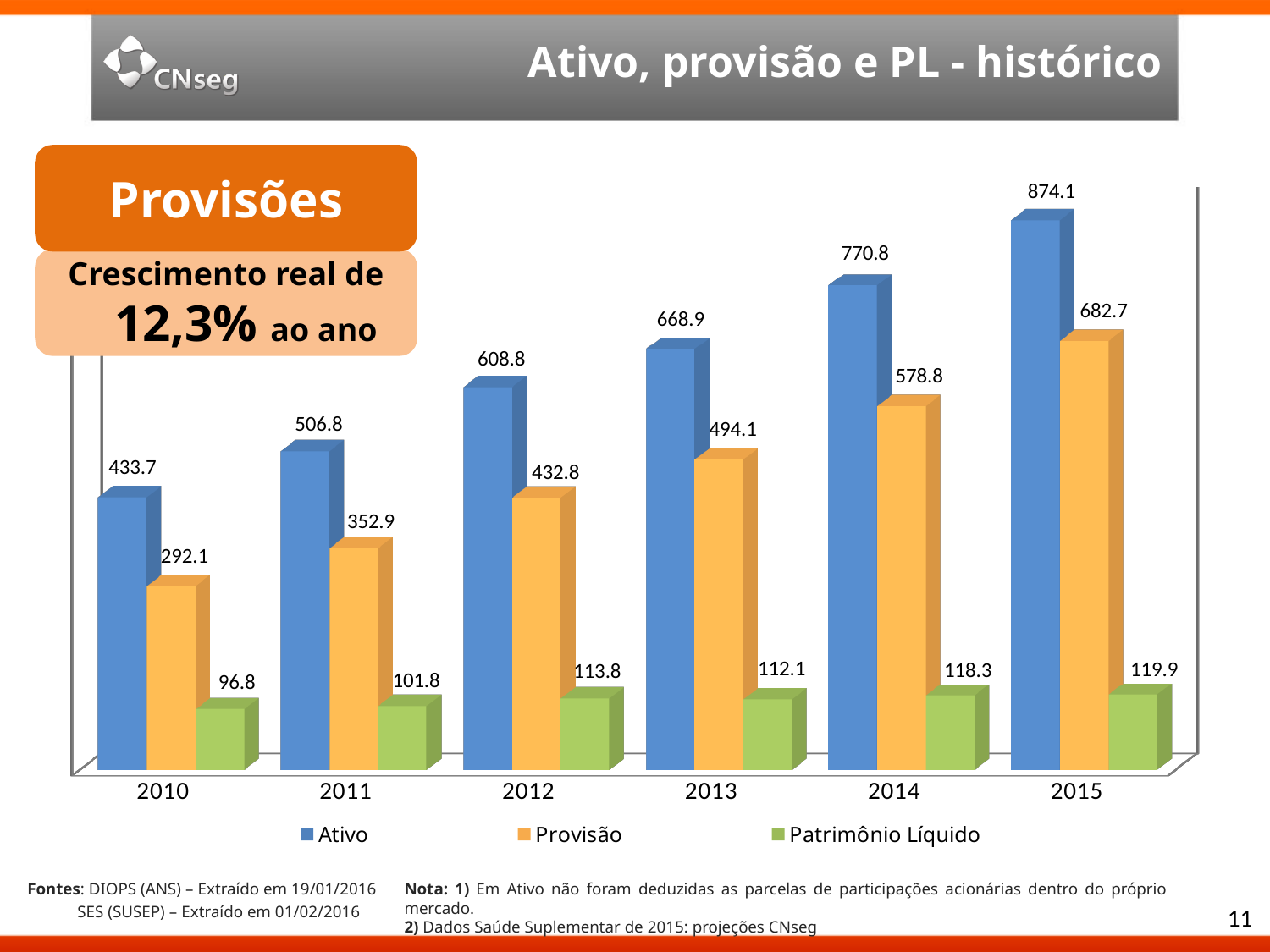
What is the value of Patrimônio Líquido for 2010? 96.8 What is the value of Ativo for 2015? 874.1 What is the value of Provisão for 2012? 432.8 How many series does the legend list? 3 How many years are shown on the x axis? 6 Does Ativo rise or fall from 2010 to 2015? Rise What kind of chart is shown on the slide? Bar chart In which year is Ativo lowest? 2010 What is the title of the slide containing the chart? Ativo, provisão e PL - histórico What is the difference between Ativo and Provisão in 2014? 192.0 In which year is Provisão highest? 2015 Which is larger in 2013: Provisão or Patrimônio Líquido? Provisão